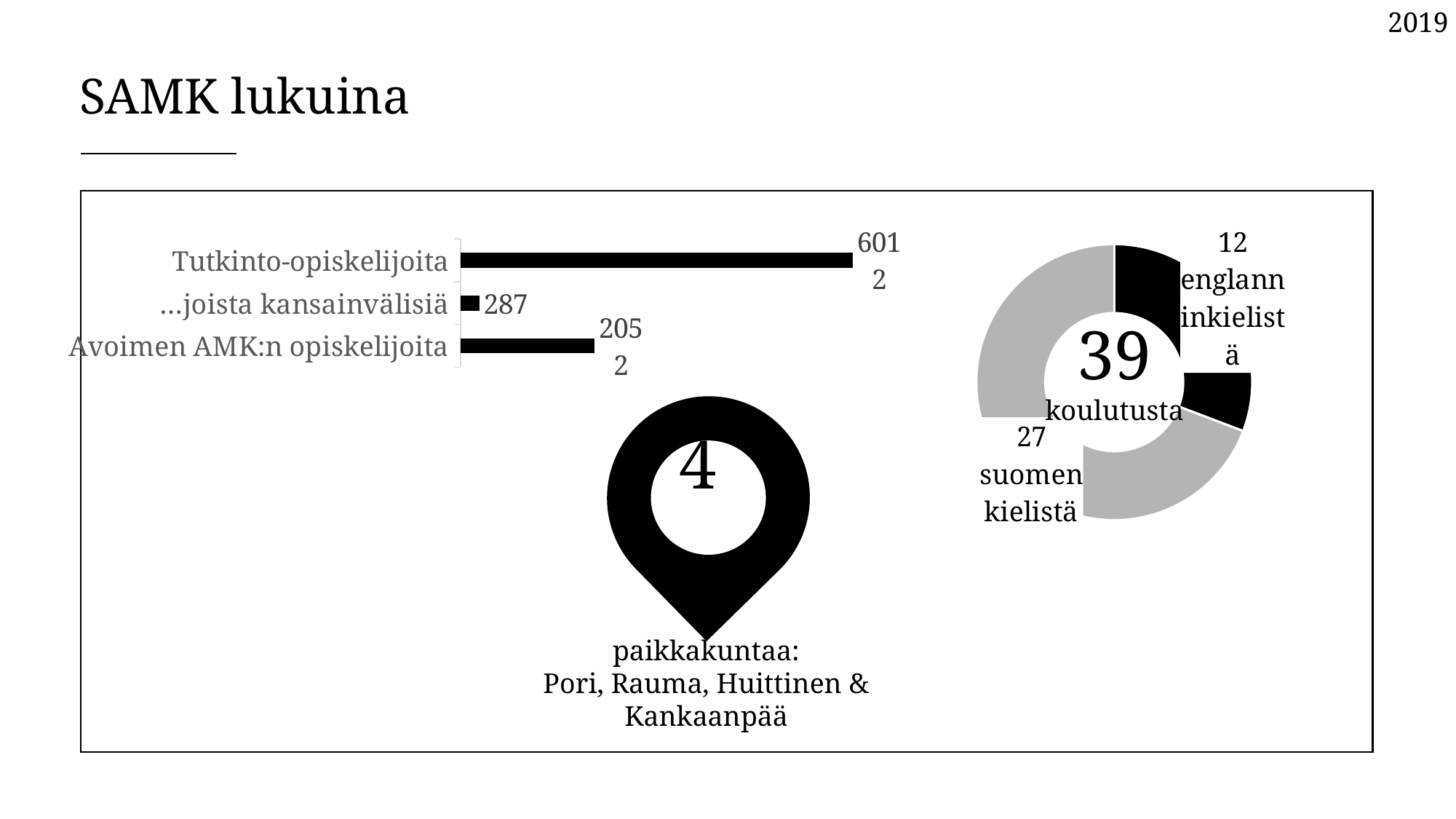
In the bar chart on the left, which category has the lowest value? ...joista kansainvälisiä In the doughnut chart on the right, how many are englanninkielistä? 12 In the bar chart on the left, what is the value for "Avoimen AMK:n opiskelijoita"? 2052 In the bar chart on the left, which category has the highest value? Tutkinto-opiskelijoita What kind of chart is the chart on the left of the slide? bar chart In the doughnut chart on the right, how many more suomenkielistä than englanninkielistä are there? 15 In the bar chart on the left, what is the difference between "Tutkinto-opiskelijoita" and "Avoimen AMK:n opiskelijoita"? 3960 In the bar chart on the left, what is the value for "...joista kansainvälisiä"? 287 In the bar chart on the left, which is larger: "Avoimen AMK:n opiskelijoita" or "...joista kansainvälisiä"? Avoimen AMK:n opiskelijoita In the bar chart on the left, how many categories are shown? 3 In the doughnut chart on the right, how many koulutusta are shown in the centre? 39 In the bar chart on the left, what is the value for "Tutkinto-opiskelijoita"? 6012